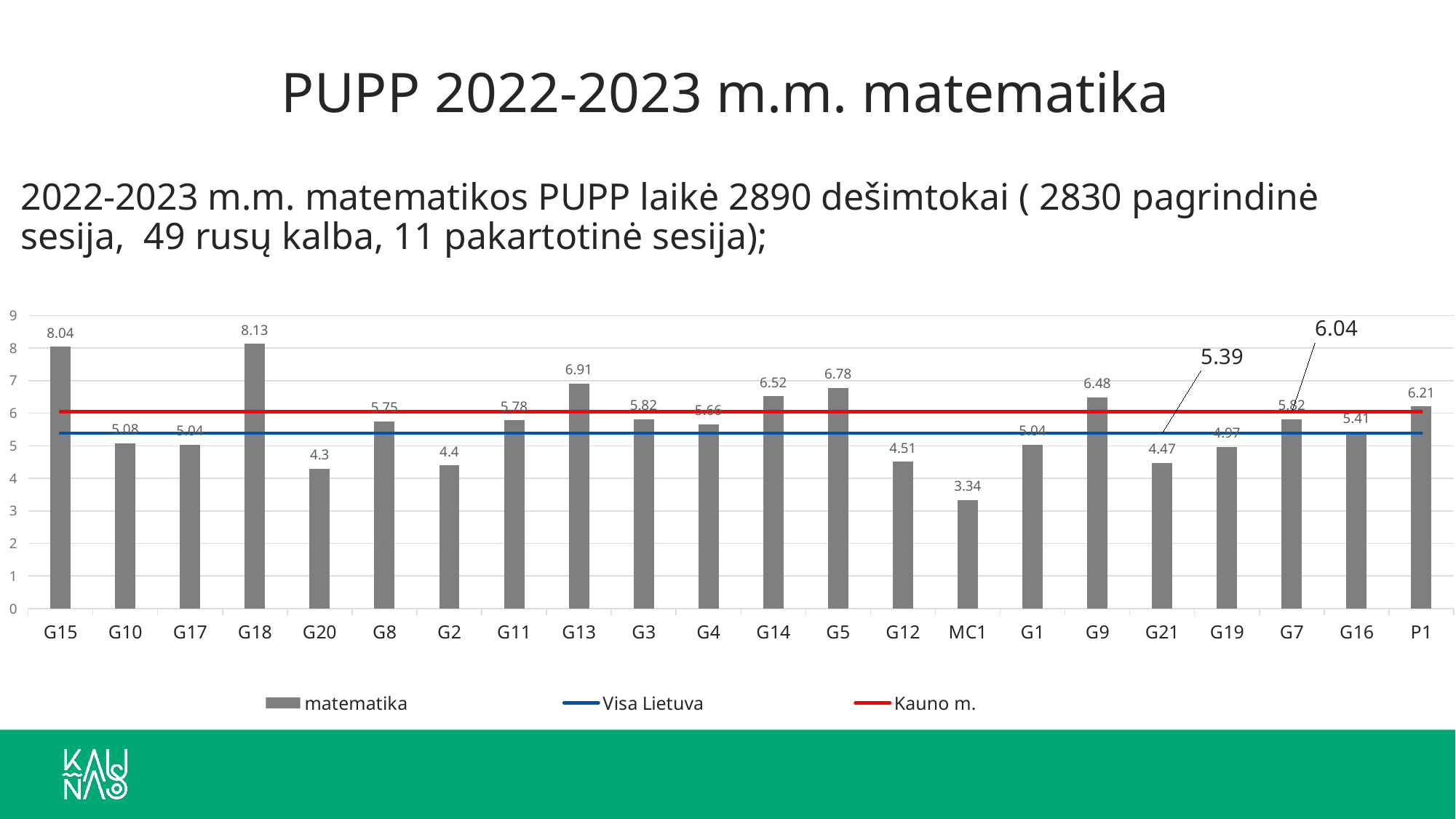
What is the matematika value for G13? 6.91 What is the matematika value for MC1? 3.34 How many series does the legend list? 3 How many categories are shown on the x axis? 22 What value is labelled for the Kauno m. line? 6.04 Which category has the highest matematika value? G18 What kind of chart is used to show the matematika values? Bar chart Which category has the lowest matematika value? MC1 What is the difference between the matematika values for G18 and G15? 0.09 What value is labelled for the Visa Lietuva line? 5.39 Which has a higher matematika value, G5 or G14? G5 What is the matematika value for G18? 8.13